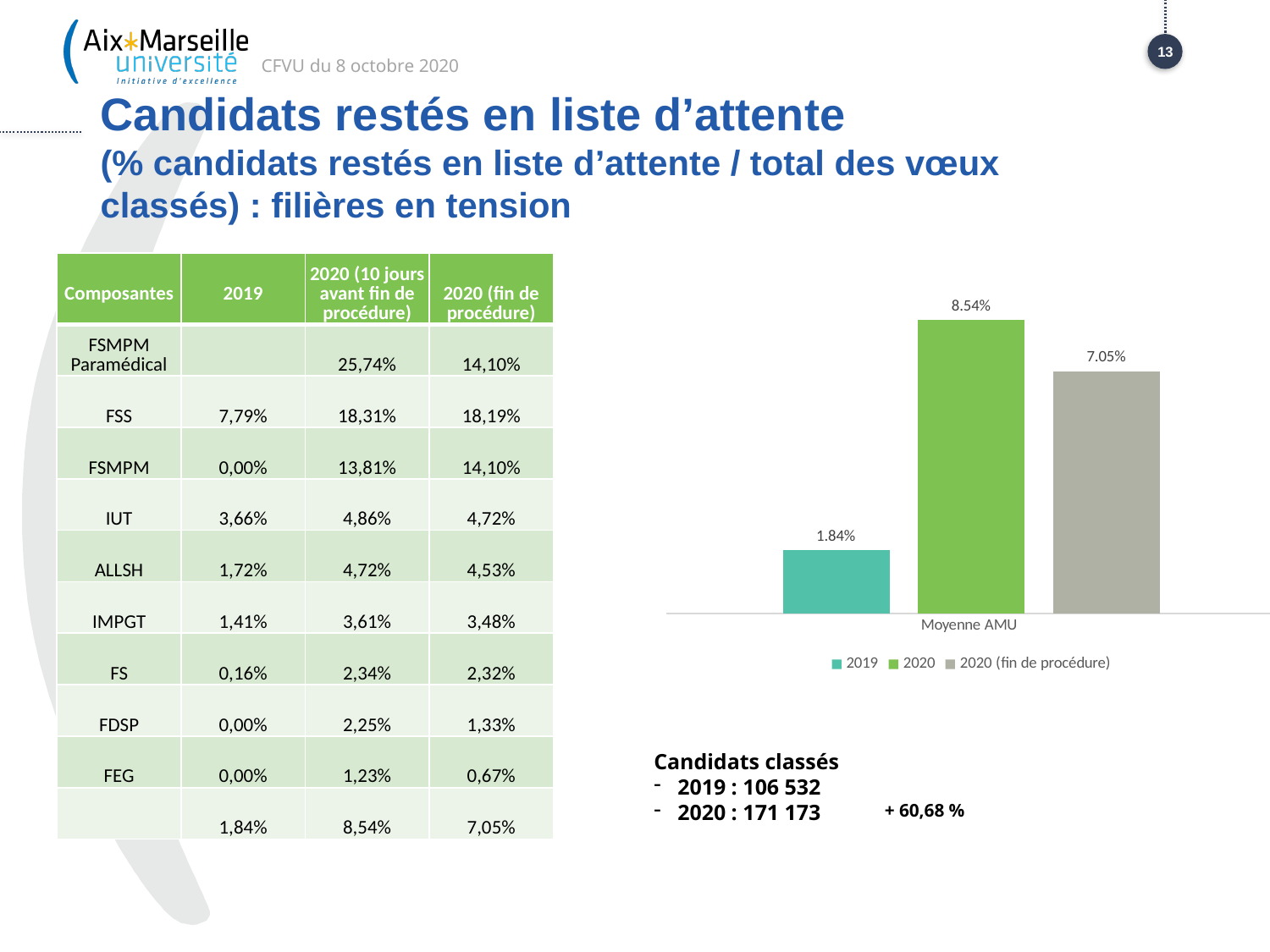
What kind of chart is shown on the slide? Bar chart What is the category label shown on the x axis of the chart? Moyenne AMU What is the value of the 2019 bar for Moyenne AMU in the chart? 1.84% What is the difference between the 2020 bar and the 2020 (fin de procédure) bar in the chart? 1.49% Which is larger in the chart, the 2020 bar or the 2020 (fin de procédure) bar? 2020 How many series does the chart legend list? 3 How many categories are shown on the x axis of the chart? 1 What is the value of the 2020 bar for Moyenne AMU in the chart? 8.54% What is the value of the 2020 (fin de procédure) bar for Moyenne AMU in the chart? 7.05% What is the difference between the 2020 bar and the 2019 bar in the chart? 6.70% Which series has the lowest bar in the chart? 2019 Which series has the highest bar in the chart? 2020